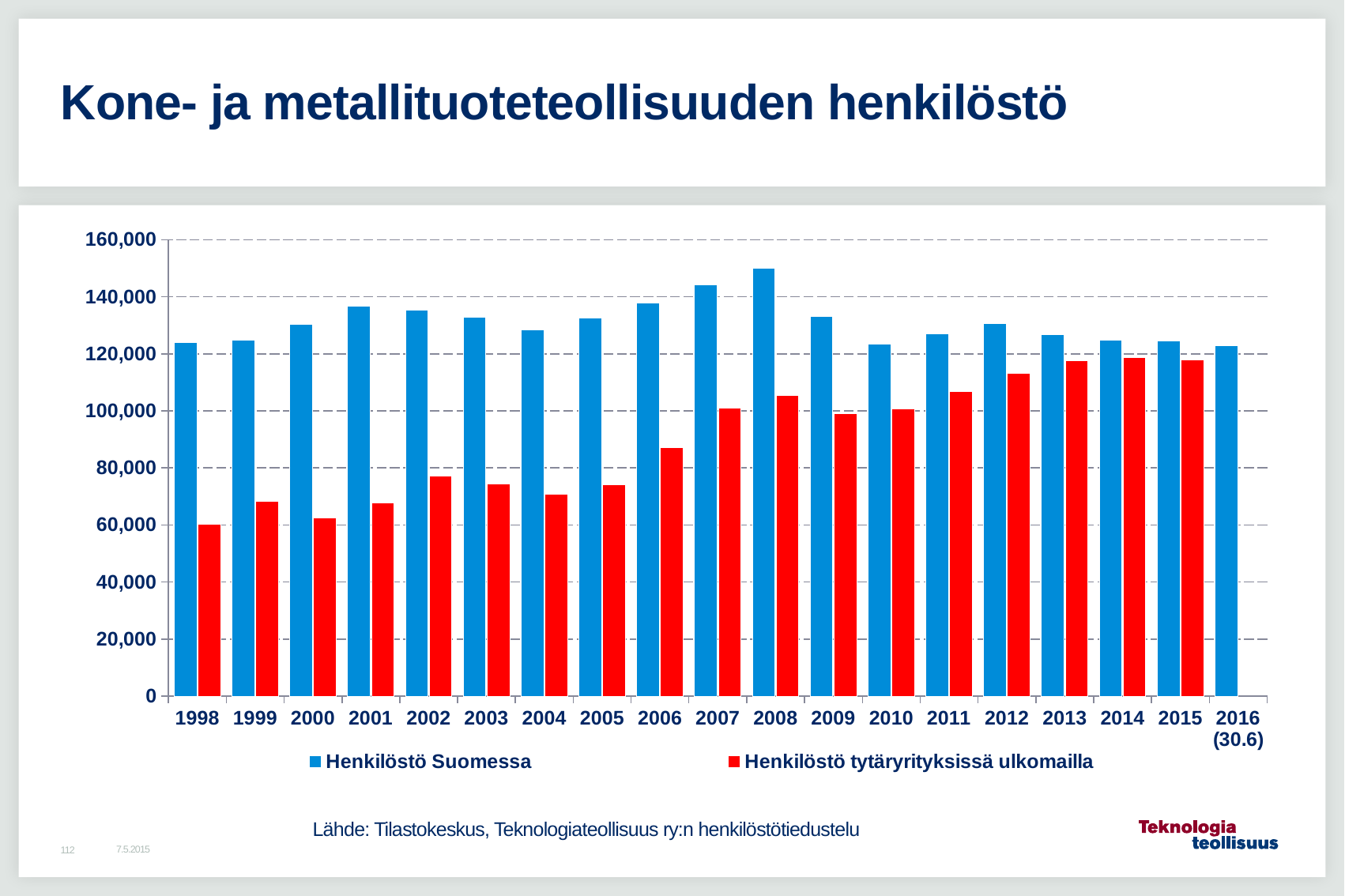
Is the value for Henkilöstö tytäryrityksissä ulkomailla in 2012 greater or less than 100,000? greater Which colour represents Henkilöstö Suomessa in the chart? blue What kind of chart is shown on the slide? bar chart Which is larger: Henkilöstö Suomessa in 2008 or Henkilöstö Suomessa in 2010? 2008 Is the value for Henkilöstö tytäryrityksissä ulkomailla in 1998 greater or less than 80,000? less In which year is the value for Henkilöstö Suomessa highest? 2008 Does the value for Henkilöstö tytäryrityksissä ulkomailla generally rise or fall from 1998 to 2015? rise Is the value for Henkilöstö Suomessa in 2008 greater or less than 140,000? greater Which is larger in 1998: Henkilöstö Suomessa or Henkilöstö tytäryrityksissä ulkomailla? Henkilöstö Suomessa How many series does the legend list? 2 How many year categories are shown on the x axis? 19